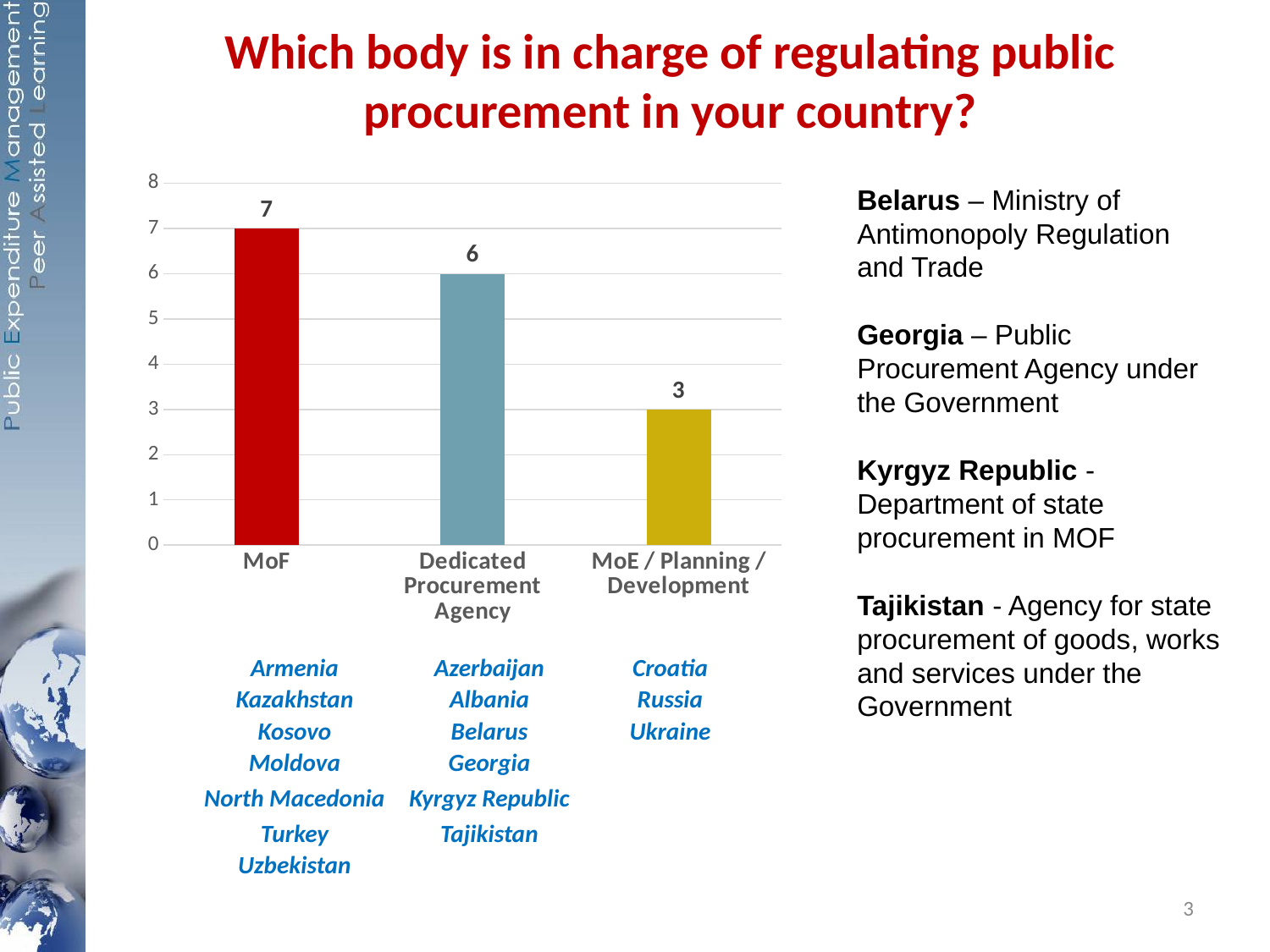
Which category has the lowest value? MoE / Planning / Development What is the maximum value shown on the vertical axis? 8 What is the value for MoF? 7 Is the value for Dedicated Procurement Agency greater or less than 5? greater Which category has the highest value? MoF What is the difference between the values for MoF and MoE / Planning / Development? 4 Which is larger, the value for Dedicated Procurement Agency or the value for MoE / Planning / Development? Dedicated Procurement Agency What is the value for MoE / Planning / Development? 3 What is the difference between the values for MoF and Dedicated Procurement Agency? 1 What kind of chart is shown on the slide? bar chart What is the value for Dedicated Procurement Agency? 6 How many categories are shown in the chart? 3